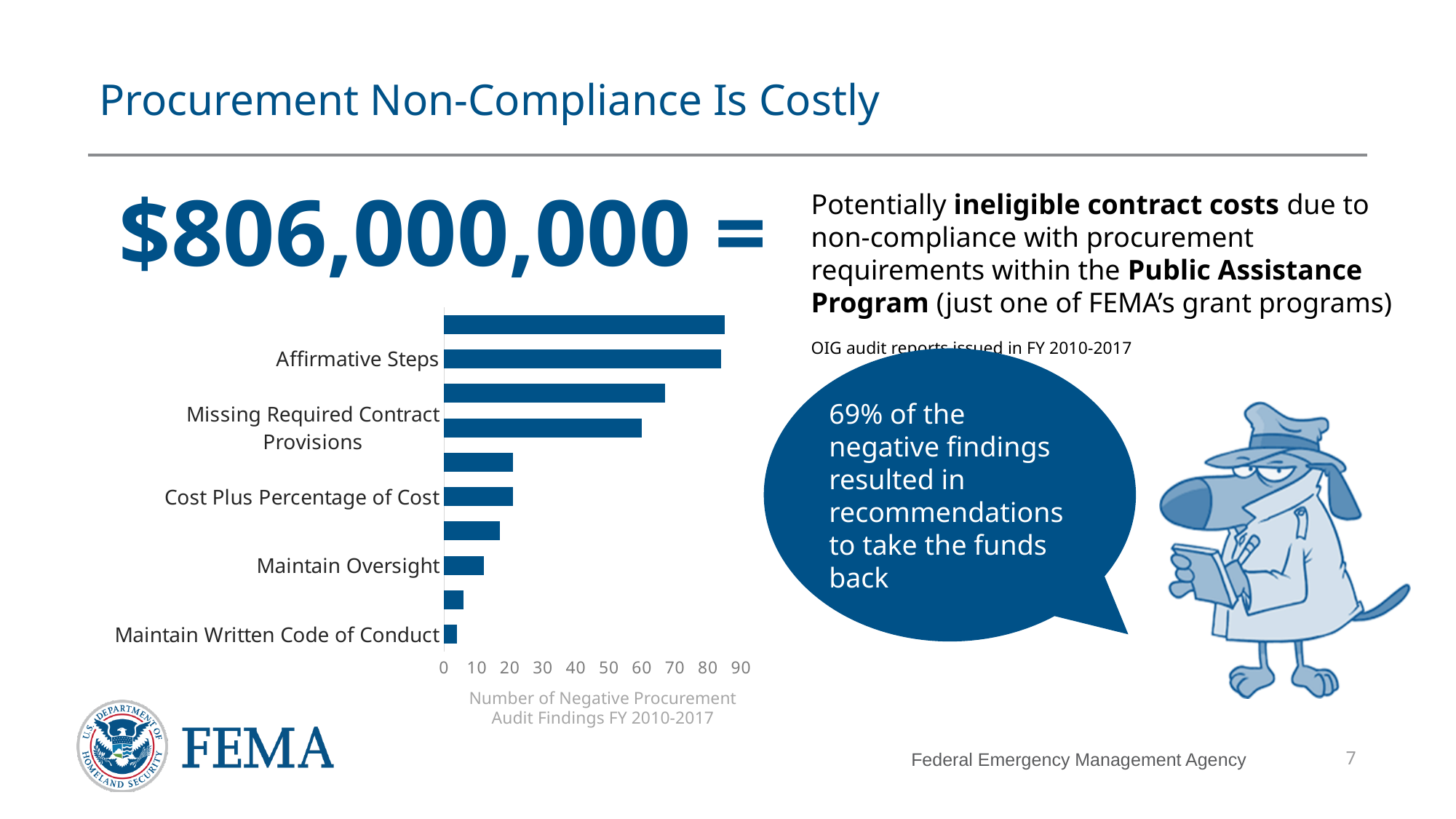
How many bars does the chart contain? 10 Is the value for Cost Plus Percentage of Cost greater or less than 30? less Is the value for Maintain Oversight greater or less than 20? less Which labeled category has the shortest bar in the chart? Maintain Written Code of Conduct Is the value for Affirmative Steps greater or less than 80? greater Which has more negative findings, Cost Plus Percentage of Cost or Maintain Oversight? Cost Plus Percentage of Cost What is the title of the chart's horizontal axis? Number of Negative Procurement Audit Findings FY 2010-2017 Which has more negative findings, Affirmative Steps or Missing Required Contract Provisions? Affirmative Steps Which labeled category has the longest bar in the chart? Affirmative Steps What kind of chart is shown on the slide? bar chart